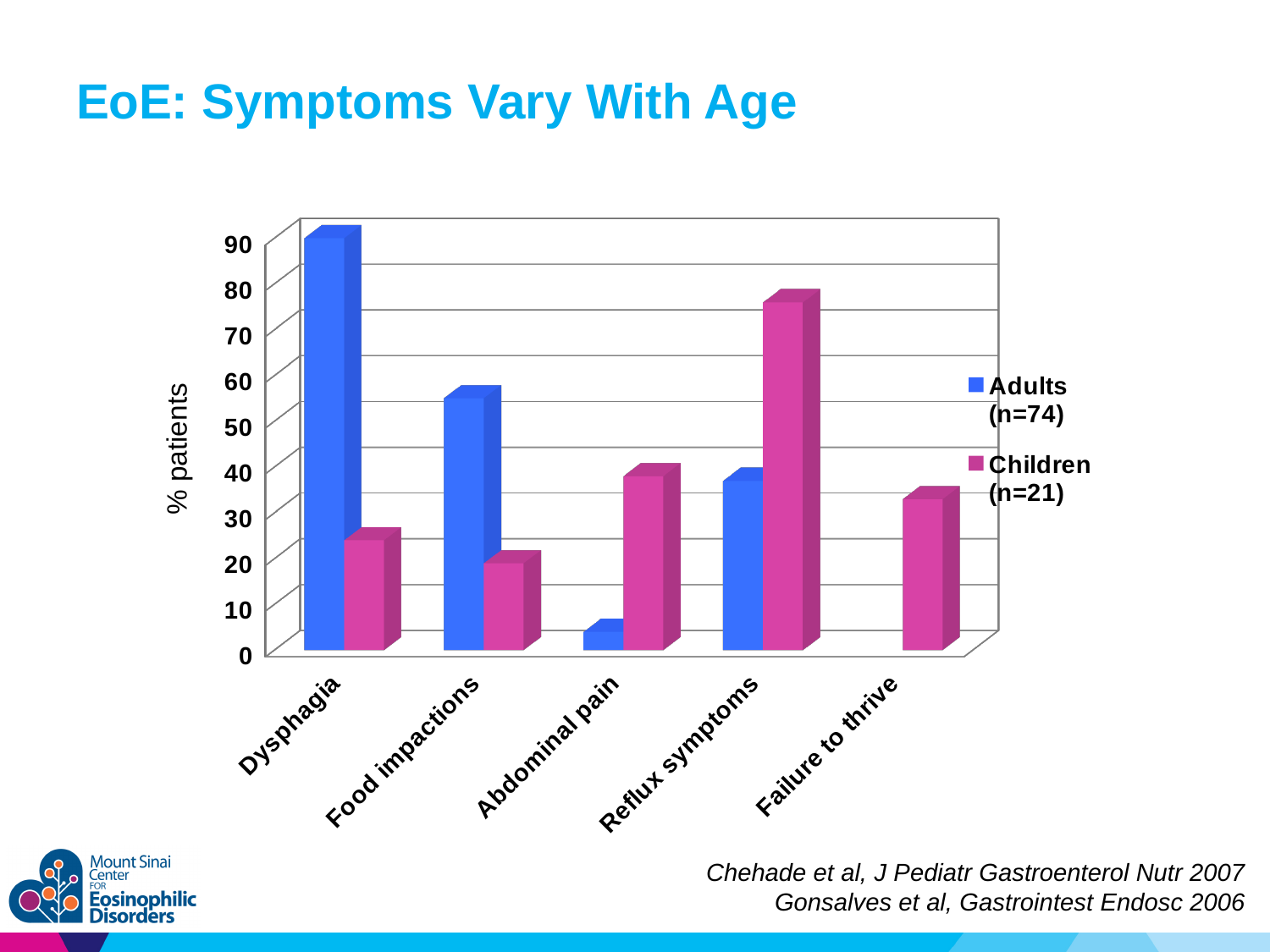
How many symptom categories are shown on the x axis? 5 Is the value for Adults with Food impactions greater or less than 50? greater Is the value for Adults with Dysphagia greater or less than 80? greater For Abdominal pain, which group has the larger value, Adults or Children? Children How many series does the legend list? 2 For Dysphagia, which group has the larger value, Adults or Children? Adults Which symptom has the highest value for Children (n=21)? Reflux symptoms Which symptom has the highest value for Adults (n=74)? Dysphagia What kind of chart is shown on the slide? bar chart Is the value for Children with Reflux symptoms greater or less than 70? greater What is the label on the y axis? % patients